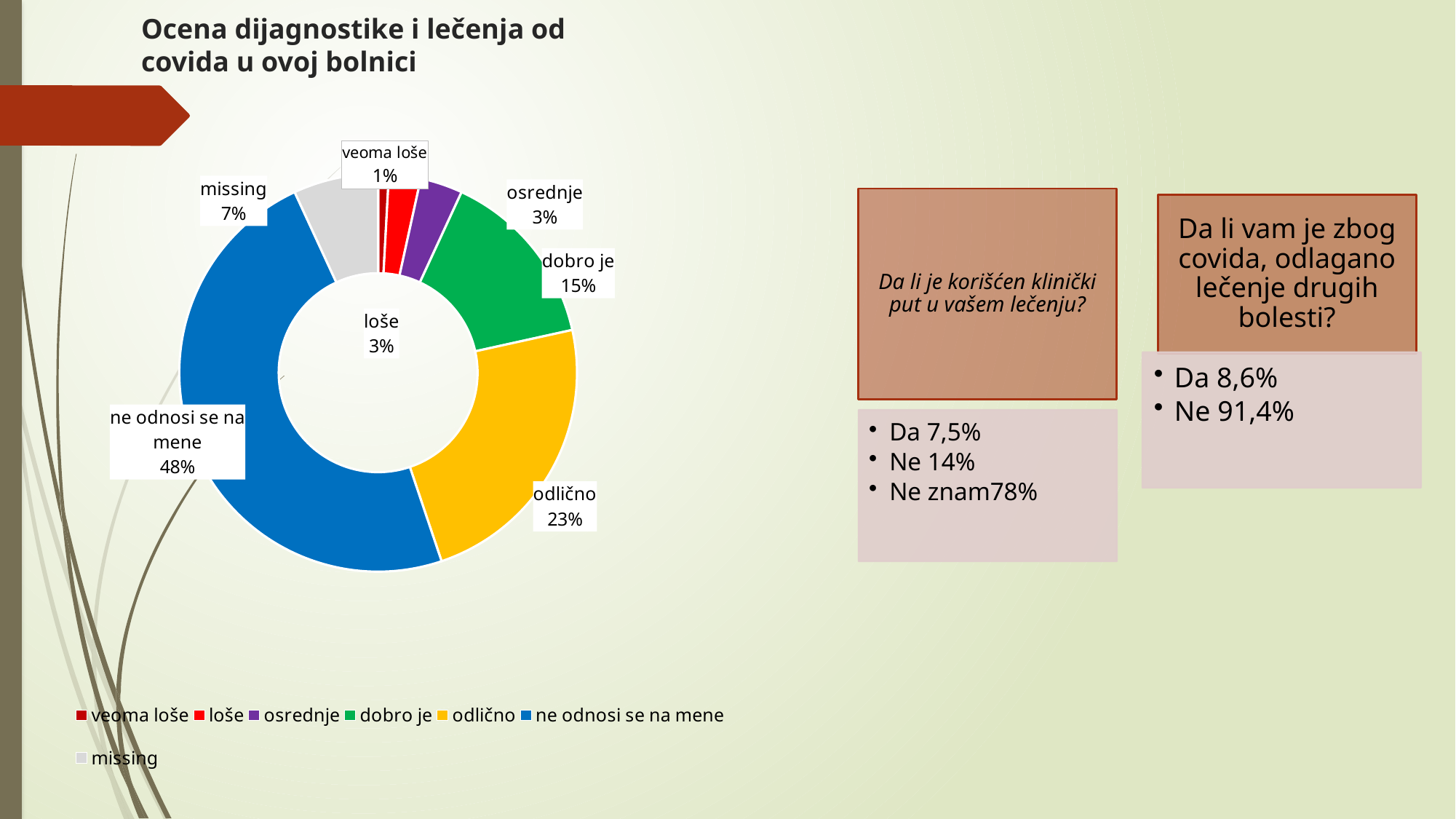
What percentage of the doughnut chart is labelled "ne odnosi se na mene"? 48% What is the value shown for "dobro je" in the doughnut chart? 15% What is the difference in percentage points between "odlično" and "dobro je" in the doughnut chart? 8 Which category has the largest share in the doughnut chart? ne odnosi se na mene What percentage is shown for "missing" in the doughnut chart? 7% What percentage does the "odlično" slice show in the doughnut chart? 23% What percentage is shown for "veoma loše" in the doughnut chart? 1% What is the title of the chart on the slide? Ocena dijagnostike i lečenja od covida u ovoj bolnici Which is larger in the doughnut chart, "missing" or "dobro je"? dobro je Which category has the smallest share in the doughnut chart? veoma loše How many categories are shown in the doughnut chart? 7 What type of chart is shown on the slide? doughnut chart